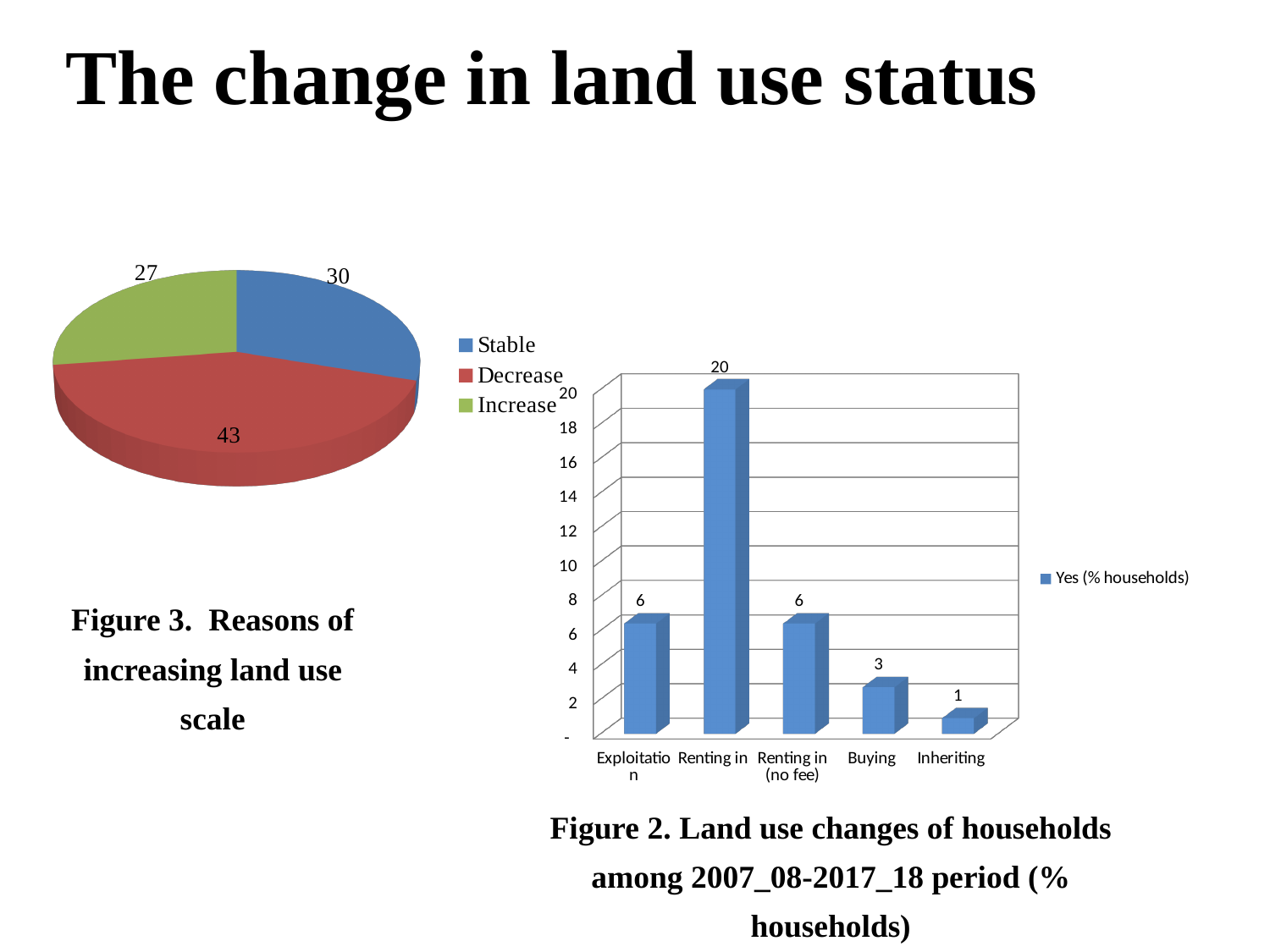
In the bar chart (Figure 2), what is the value for Renting in? 20 In the bar chart (Figure 2), what is the difference between the values for Renting in and Exploitation? 14 In the bar chart (Figure 2), what is the value for Buying? 3 What kind of chart is Figure 3 on the left of the slide? Pie chart In the pie chart (Figure 3), what is the value for Decrease? 43 In the pie chart (Figure 3), how many categories does the legend list? 3 In the pie chart (Figure 3), which category has the smallest slice? Increase In the pie chart (Figure 3), what is the difference between the values for Decrease and Stable? 13 In the bar chart (Figure 2), how many categories are shown on the x axis? 5 In the bar chart (Figure 2), what series name does the legend show? Yes (% households) In the pie chart (Figure 3), which category has the largest slice? Decrease In the bar chart (Figure 2), which category has the lowest value? Inheriting